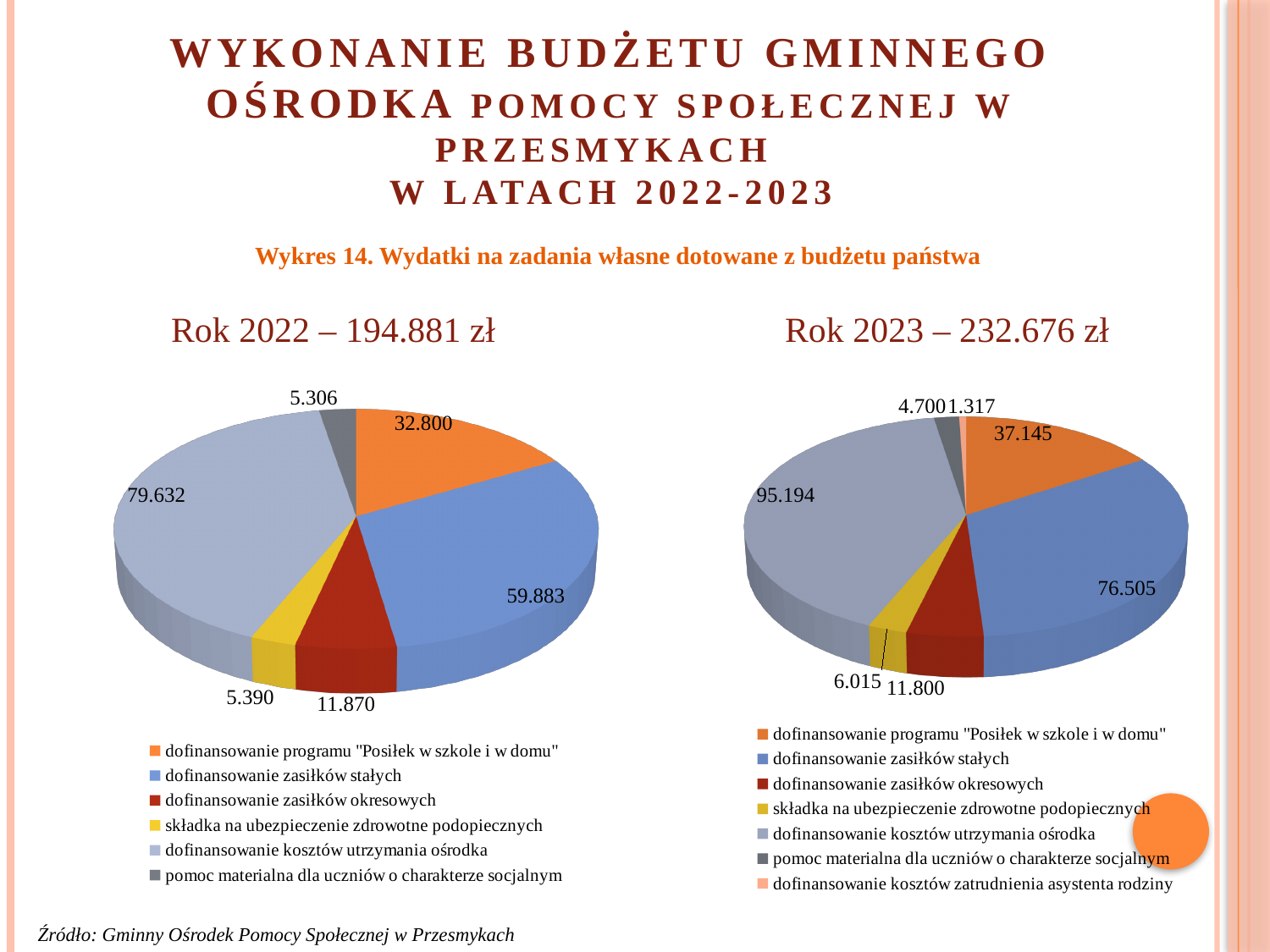
In the Rok 2023 pie chart, what is the value for dofinansowanie kosztów zatrudnienia asystenta rodziny? 1.317 How many categories does the Rok 2023 pie chart have? 7 How many entries does the legend of the Rok 2022 chart list? 6 In the Rok 2023 pie chart, which category has the largest value? dofinansowanie kosztów utrzymania ośrodka In the Rok 2022 pie chart, which category has the smallest value? pomoc materialna dla uczniów o charakterze socjalnym In the Rok 2022 pie chart, what is the difference between dofinansowanie zasiłków stałych and dofinansowanie programu "Posiłek w szkole i w domu"? 27.083 Which is larger: dofinansowanie zasiłków okresowych in the Rok 2022 chart or in the Rok 2023 chart? Rok 2022 In the Rok 2023 pie chart, what is the value for dofinansowanie zasiłków stałych? 76.505 In the Rok 2022 pie chart, what is the value for dofinansowanie kosztów utrzymania ośrodka? 79.632 In the Rok 2022 pie chart, what is the value for składka na ubezpieczenie zdrowotne podopiecznych? 5.390 What is the difference between dofinansowanie kosztów utrzymania ośrodka in the Rok 2023 chart and in the Rok 2022 chart? 15.562 What type of chart is used for Rok 2022 and Rok 2023? pie chart